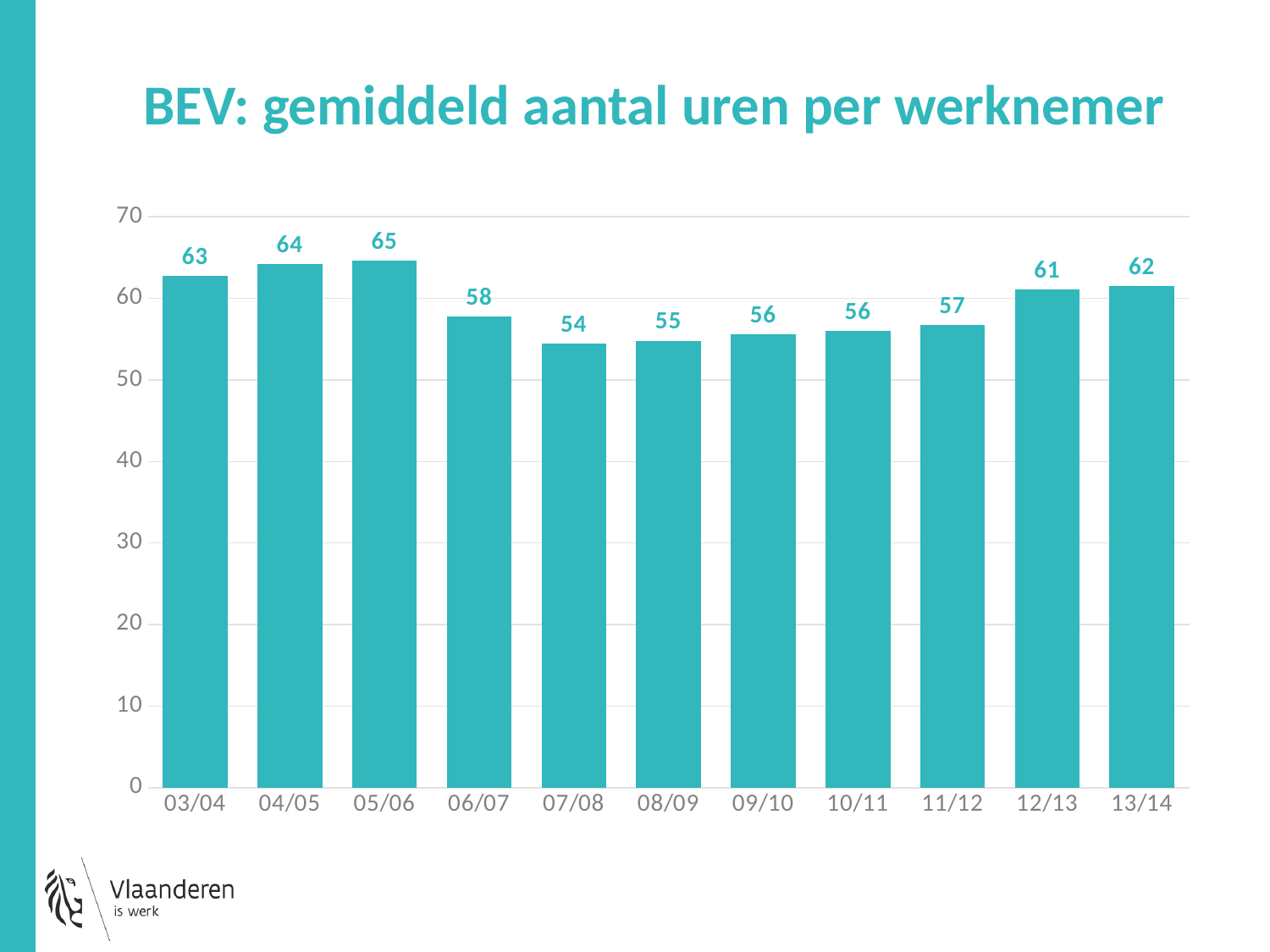
How many categories are shown on the x axis? 11 What is the value for 13/14? 62 Which is larger, the value for 03/04 or the value for 12/13? 03/04 Do the values rise or fall from 07/08 to 13/14? rise What is the value for 05/06? 65 What kind of chart is shown on the slide? bar chart What is the title of the chart? BEV: gemiddeld aantal uren per werknemer Which category has the highest value? 05/06 Which category has the lowest value? 07/08 What is the value for 07/08? 54 Is the value for 06/07 greater or less than 50? greater What is the difference between the values for 05/06 and 07/08? 11